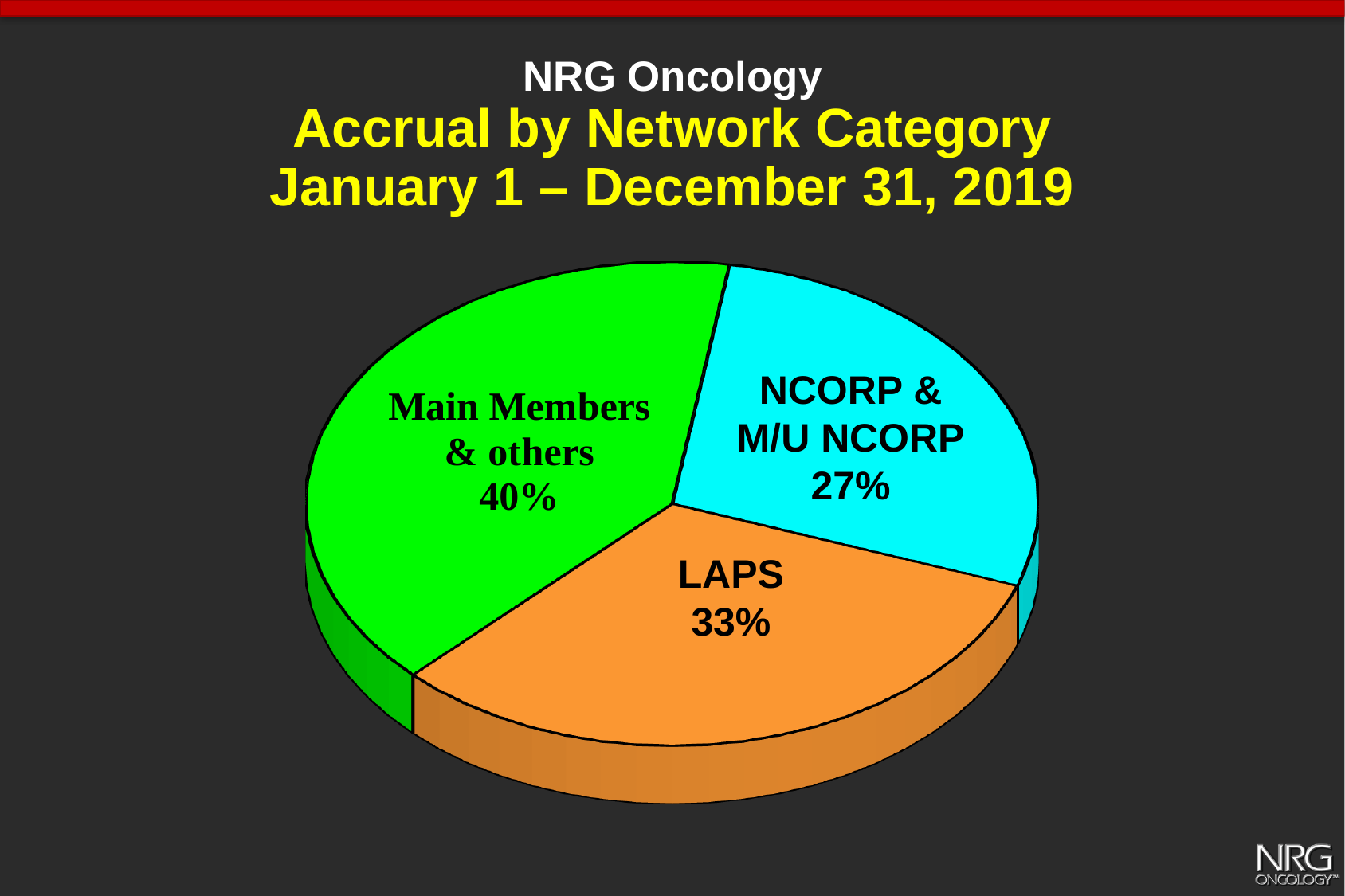
Which has a larger share of accrual, LAPS or NCORP & M/U NCORP? LAPS What colour is the LAPS slice? Orange Which network category has the smallest share of accrual? NCORP & M/U NCORP Which network category has the largest share of accrual? Main Members & others What kind of chart is shown on the slide? Pie chart What share of accrual is attributed to NCORP & M/U NCORP? 27% What time period does the chart cover? January 1 – December 31, 2019 How many network categories are shown in the pie chart? 3 What share of accrual is attributed to LAPS? 33% What is the difference in percentage points between Main Members & others and LAPS? 7 What share of accrual is attributed to Main Members & others? 40% What is the difference in percentage points between LAPS and NCORP & M/U NCORP? 6